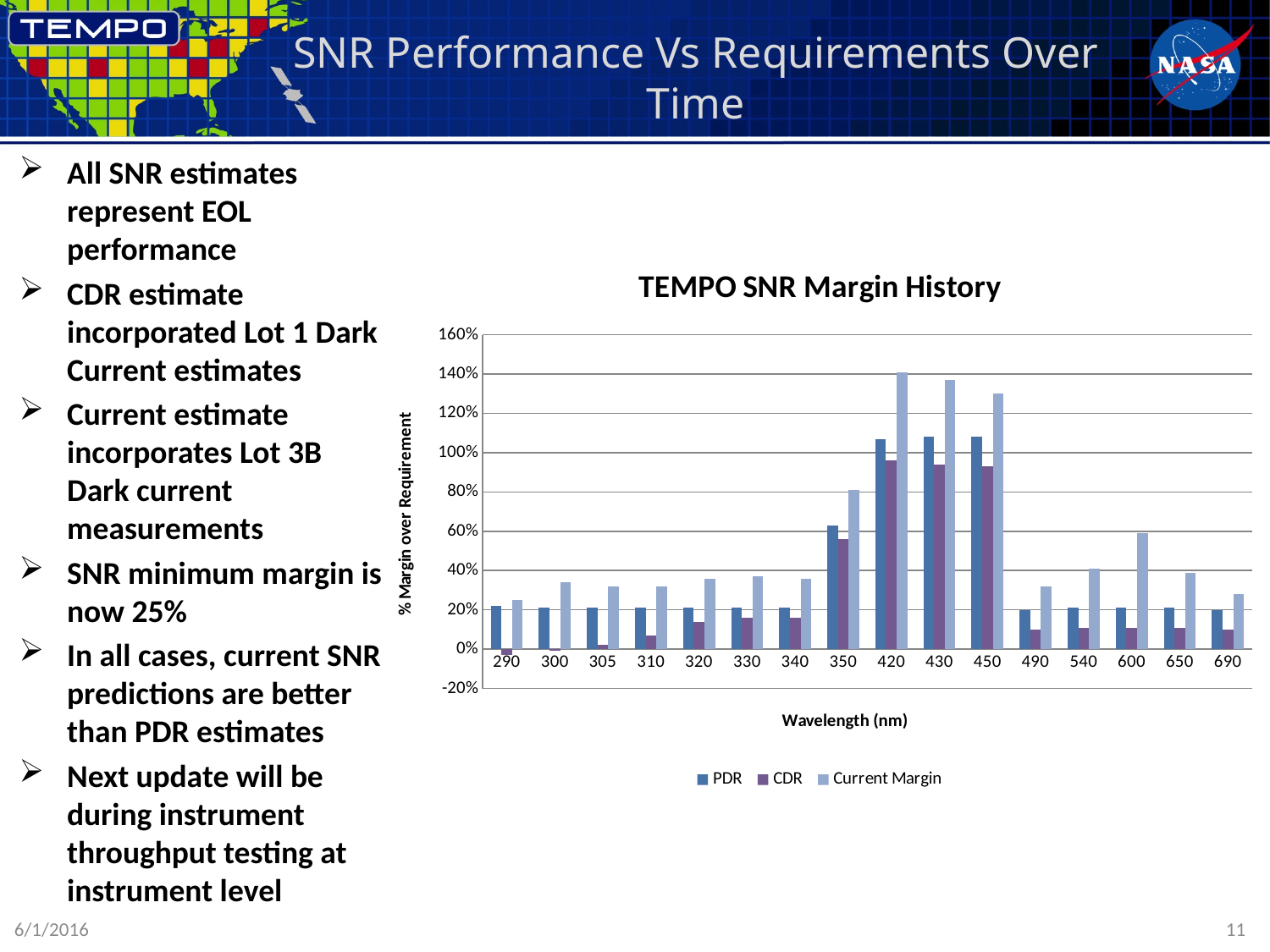
At which wavelength is the CDR value lowest? 290 How many wavelength categories are shown on the x axis of the chart? 16 What kind of chart is shown on the slide? bar chart Is the PDR value at 290 nm greater or less than 40%? less How many series does the chart legend list? 3 Is the Current Margin value at 600 nm greater or less than 40%? greater What is the title of the chart? TEMPO SNR Margin History Is the Current Margin value at 430 nm greater or less than 120%? greater What is the label of the x axis of the chart? Wavelength (nm) Which is larger, the Current Margin value at 600 nm or at 540 nm? 600 nm